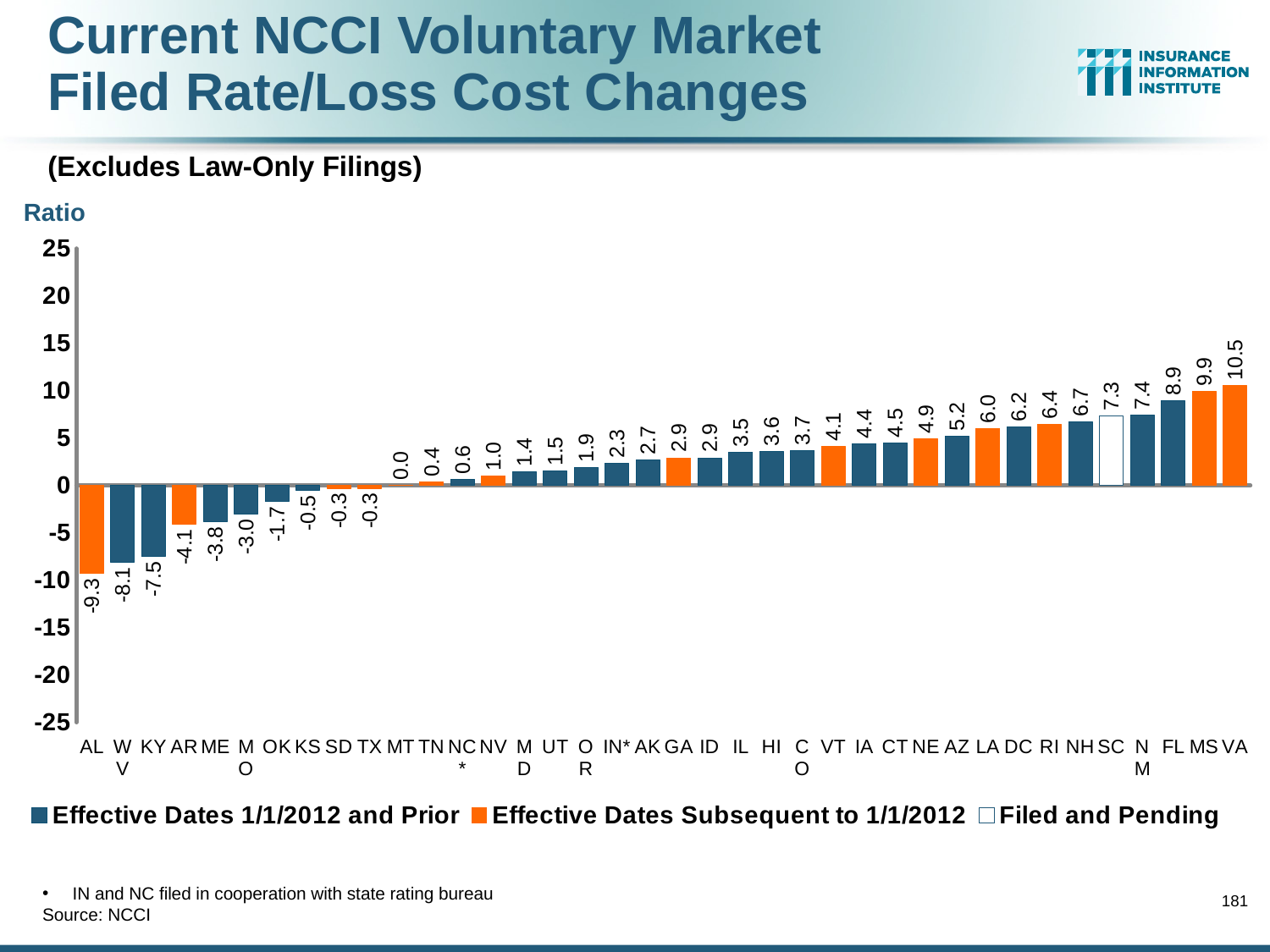
How many states are shown on the x axis? 38 What kind of chart is this? bar chart Is the value for VA greater or less than 10? greater What is the difference between the values for VA and AL? 19.8 Which state has the highest value? VA Which is larger, the value for MS or the value for FL? MS What is the value for VA? 10.5 What is the value for MT? 0.0 Which state's bar is shown as Filed and Pending? SC What is the value for AL? -9.3 How many series does the legend list? 3 Which state has the lowest value? AL